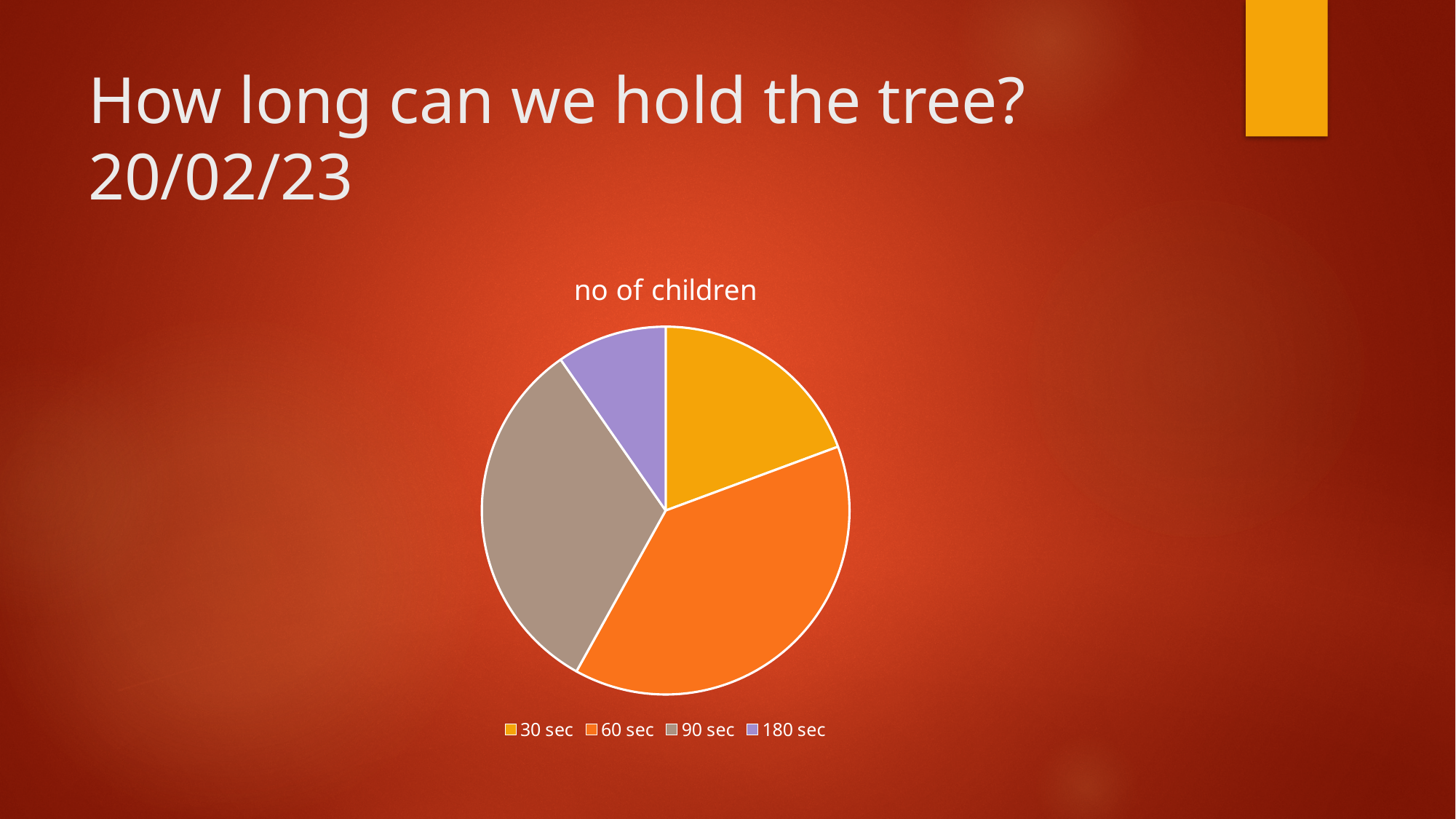
Which category has the largest slice of the pie? 60 sec How many entries does the legend list? 4 Which slice is larger, 30 sec or 180 sec? 30 sec Which category is shown in purple in the pie chart? 180 sec Which slice is larger, 60 sec or 90 sec? 60 sec Which category has the smallest slice of the pie? 180 sec Which slice is larger, 30 sec or 90 sec? 90 sec What is the title of the chart? no of children How many slices does the pie chart have? 4 What kind of chart is shown on the slide? pie chart